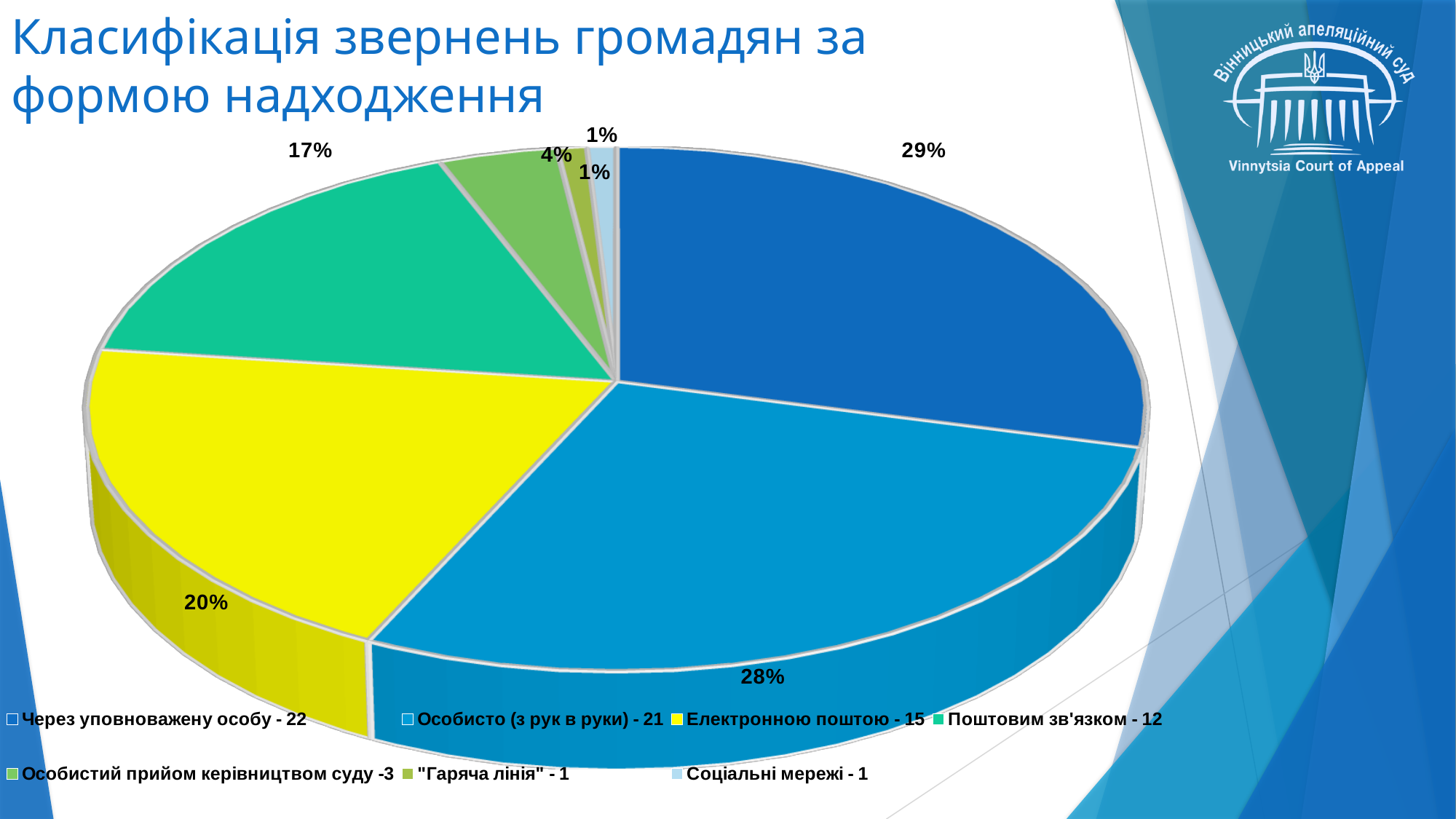
What share of the pie does "Особистий прийом керівництвом суду" take? 4% What share of the pie does "Поштовим зв'язком" take? 17% What kind of chart is shown on the slide? pie chart According to the legend, how many appeals were received "Через уповноважену особу"? 22 What share of the pie does "Електронною поштою" take? 20% Which category has the largest share of the pie? Через уповноважену особу What is the difference in percentage points between the "Електронною поштою" slice and the "Поштовим зв'язком" slice? 3 What is the title of the chart on the slide? Класифікація звернень громадян за формою надходження Which is larger: the share for "Електронною поштою" or the share for "Особистий прийом керівництвом суду"? Електронною поштою How many categories does the pie chart have? 7